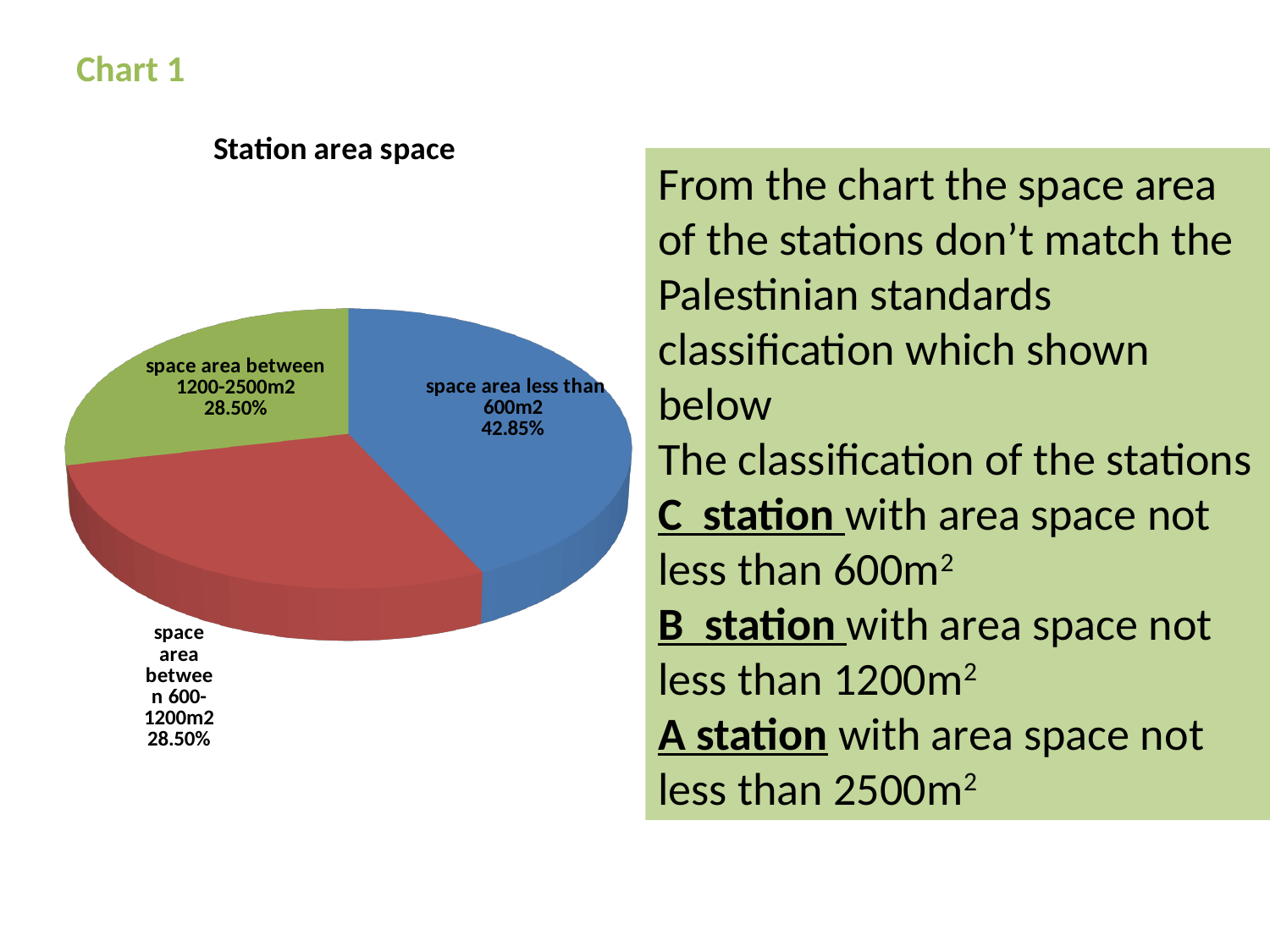
Which slice of the pie is the largest? space area less than 600m2 Do the slices for space area between 600-1200m2 and space area between 1200-2500m2 have the same share? yes Is the share for space area less than 600m2 greater or less than 40%? greater How many slices does the pie chart have? 3 What is the difference in percentage points between the slice for space area less than 600m2 and the slice for space area between 1200-2500m2? 14.35 What is the title of the chart? Station area space Which is larger: the slice for space area less than 600m2 or the slice for space area between 600-1200m2? space area less than 600m2 What share of the pie is the slice for space area between 600-1200m2? 28.50% What share of the pie is the slice for space area between 1200-2500m2? 28.50% What share of the pie is the slice for space area less than 600m2? 42.85% What colour is the slice for space area less than 600m2? blue What kind of chart is shown on the slide? pie chart